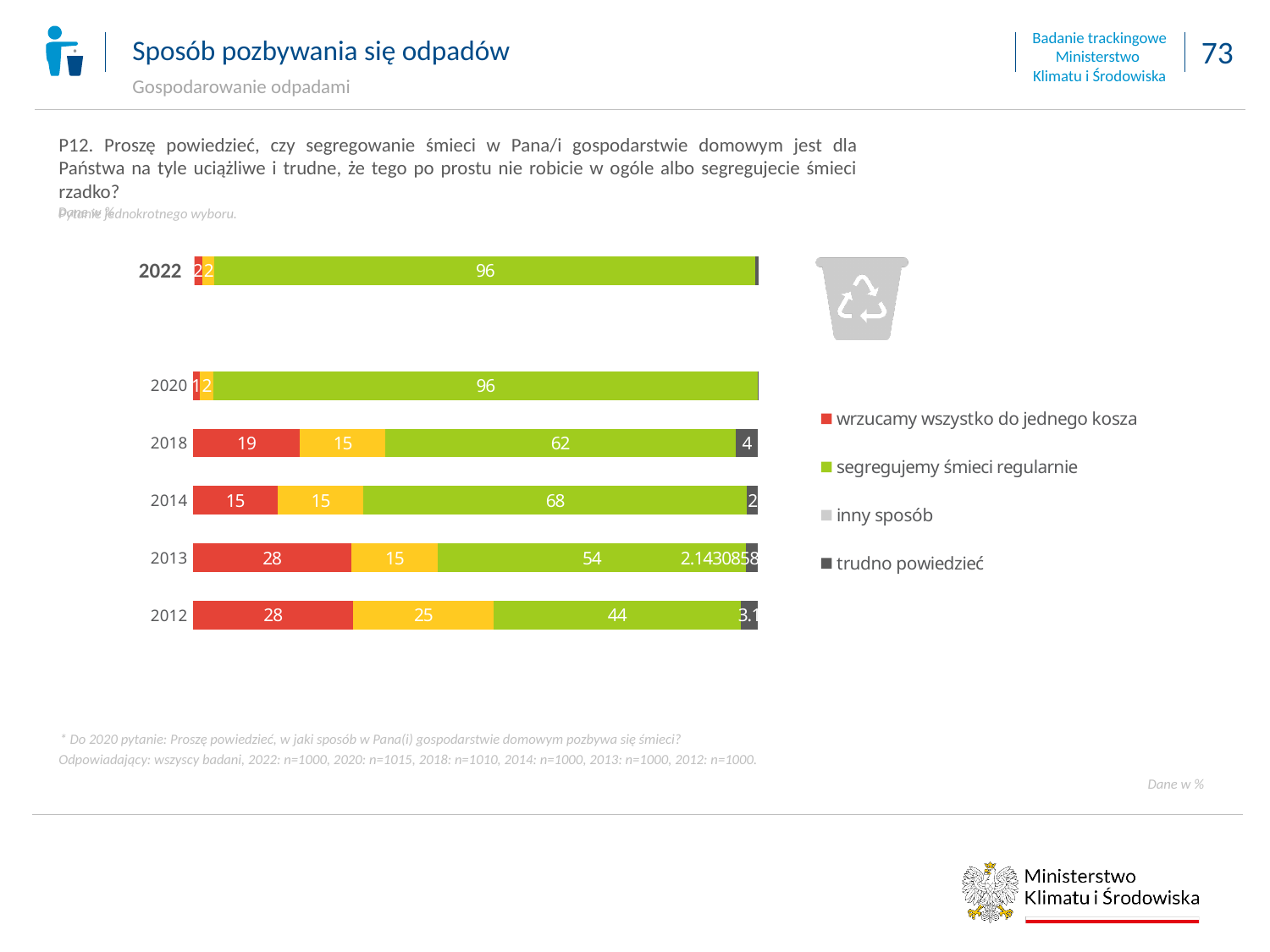
Does the value for "segregujemy śmieci regularnie" rise or fall from 2012 to 2022? Rise What is the value for "wrzucamy wszystko do jednego kosza" in 2013? 28 Which year has the highest value for "trudno powiedzieć"? 2018 What is the value for "trudno powiedzieć" in 2018? 4 What kind of chart is shown on the slide? Stacked bar chart Which year has the larger value for "wrzucamy wszystko do jednego kosza", 2018 or 2014? 2018 What is the value for "segregujemy śmieci regularnie" in 2018? 62 What is the value for "segregujemy śmieci regularnie" in 2012? 44 Which year has the lowest value for "segregujemy śmieci regularnie"? 2012 How many series does the legend list? 4 What is the difference between the "segregujemy śmieci regularnie" values for 2014 and 2018? 6 How many years are shown in the chart? 6